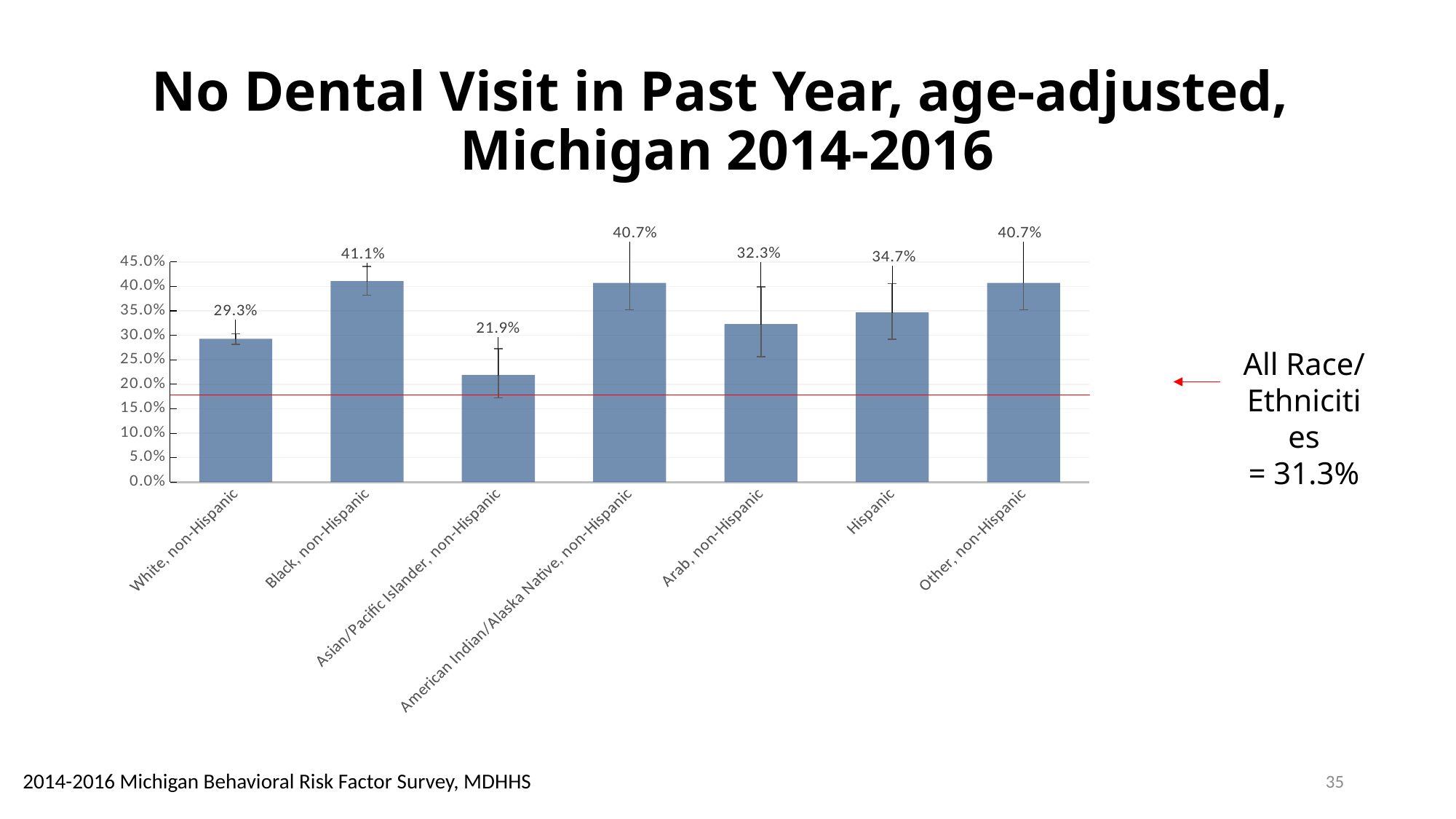
Which category has the highest value? Black, non-Hispanic What is the value for Hispanic? 34.7% How many categories are shown on the x axis? 7 According to the annotation next to the chart, what is the value for all race/ethnicities combined? 31.3% What is the value for Black, non-Hispanic? 41.1% What is the difference between the values for Black, non-Hispanic and White, non-Hispanic? 11.8 percentage points What is the difference between the values for Other, non-Hispanic and Asian/Pacific Islander, non-Hispanic? 18.8 percentage points What is the value for Arab, non-Hispanic? 32.3% Which category has the lowest value? Asian/Pacific Islander, non-Hispanic What is the value for Asian/Pacific Islander, non-Hispanic? 21.9% What kind of chart is shown on the slide? Bar chart Which is larger, the value for Hispanic or the value for Arab, non-Hispanic? Hispanic